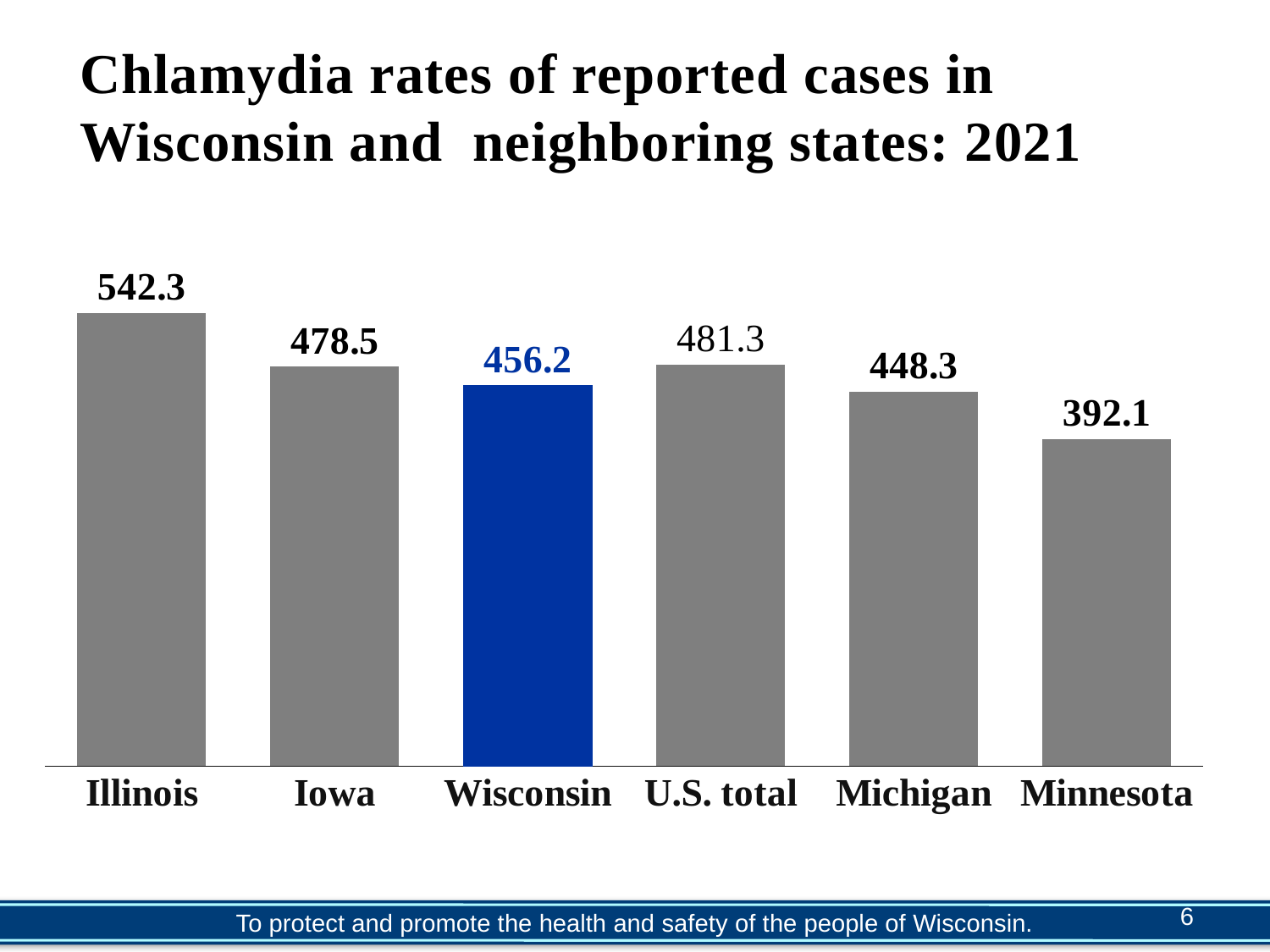
What is the difference between the Illinois rate and the Wisconsin rate? 86.1 What is the chlamydia rate for Wisconsin? 456.2 Which is larger, the rate for Iowa or the rate for Wisconsin? Iowa What is the value shown for U.S. total? 481.3 Which bar is shown in blue rather than gray? Wisconsin What is the difference between the U.S. total rate and the Michigan rate? 33.0 What is the chlamydia rate for Illinois? 542.3 Which category has the lowest chlamydia rate? Minnesota Which category has the highest chlamydia rate? Illinois What is the chlamydia rate for Minnesota? 392.1 How many categories are shown on the chart? 6 What kind of chart is shown on the slide? Bar chart